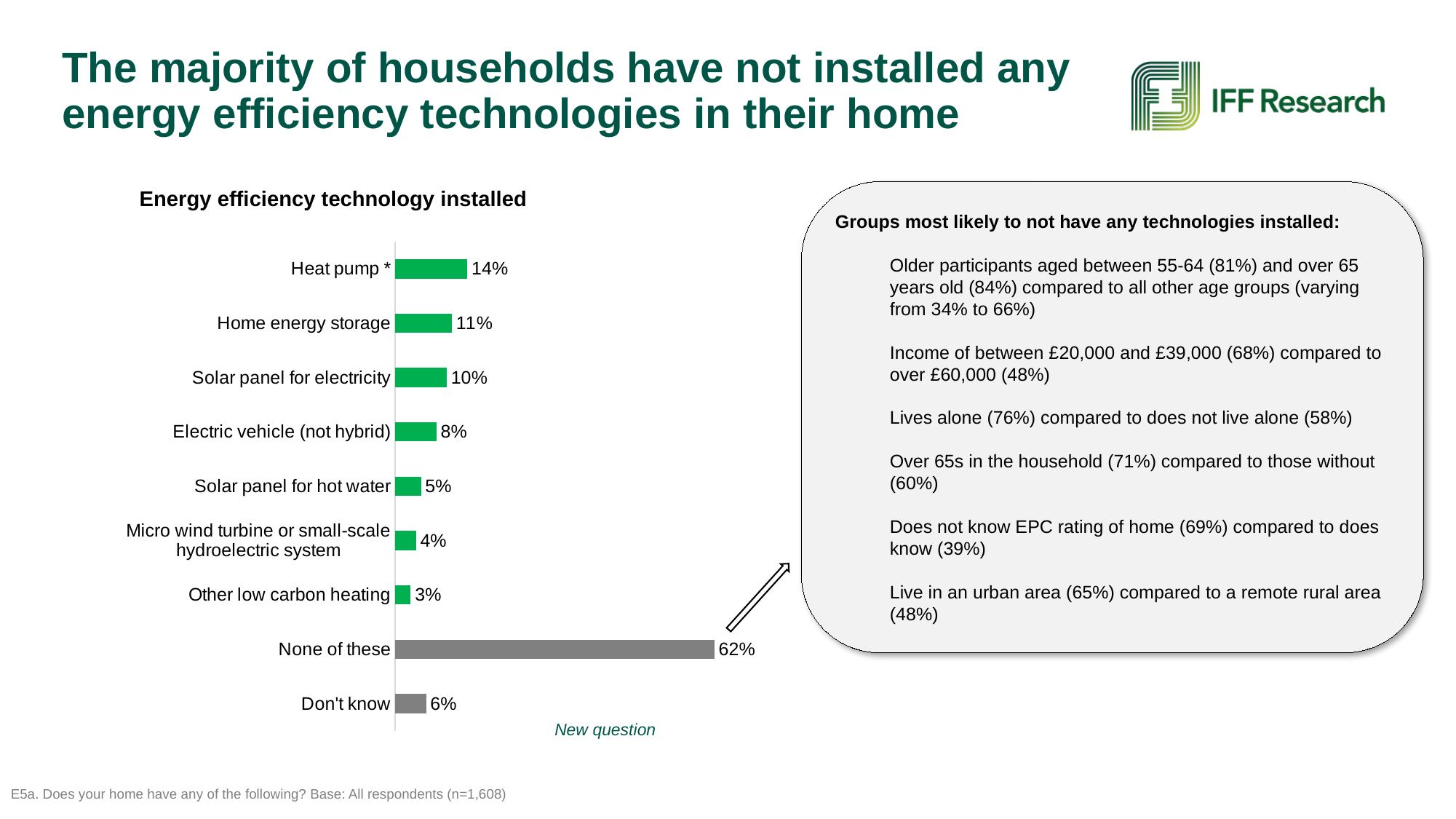
What is the difference between the values for Heat pump and Home energy storage? 3% Which category has the lowest value in the chart? Other low carbon heating Which is larger: the value for Electric vehicle (not hybrid) or Solar panel for electricity? Solar panel for electricity What is the difference between the values for 'None of these' and 'Don't know'? 56% Which category has the highest value in the chart? None of these What is the value for 'Don't know'? 6% What type of chart is shown on the slide? Bar chart What percentage of households have a solar panel for hot water? 5% What is the title of the chart? Energy efficiency technology installed What percentage of households have a heat pump installed? 14% What is the value for 'None of these'? 62% How many categories are shown in the chart? 9